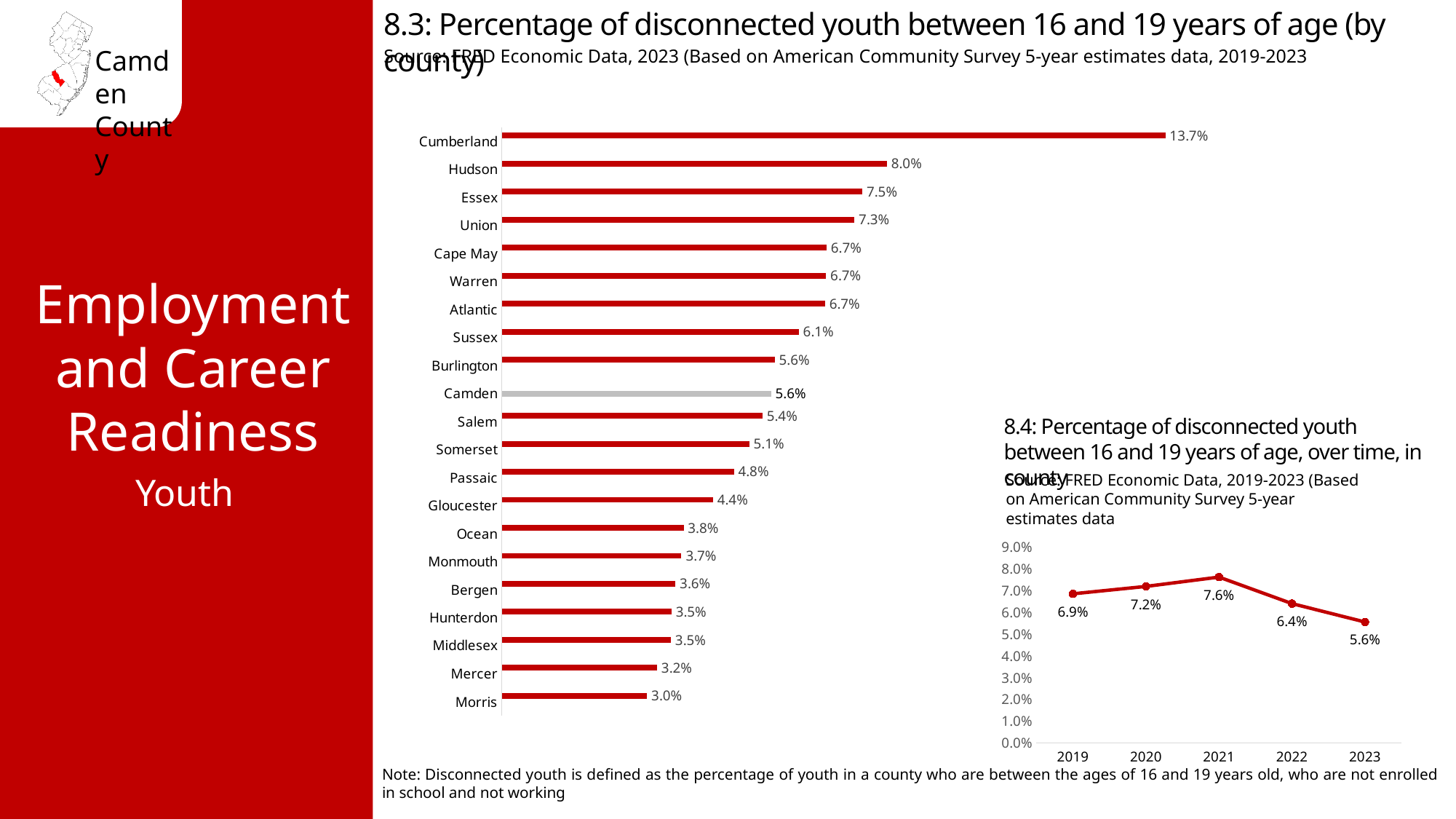
In the 8.4 line chart, what is the difference between the 2021 and 2023 values? 2.0% In the 8.4 line chart, what is the value for 2021? 7.6% In the 8.4 line chart, how many years are plotted? 5 What kind of chart is the 8.3 chart? Bar chart In the 8.3 bar chart, what is the value for Mercer? 3.2% In the 8.3 bar chart, what is the value for Camden? 5.6% In the 8.3 bar chart, which county has the highest percentage of disconnected youth? Cumberland In the 8.4 line chart, which year has the lowest value? 2023 In the 8.3 bar chart, which county has the lowest percentage of disconnected youth? Morris In the 8.3 bar chart, what is the difference between Cumberland and Hudson? 5.7% In the 8.3 bar chart, how many counties are shown? 21 In the 8.3 bar chart, which is larger, the value for Gloucester or the value for Ocean? Gloucester